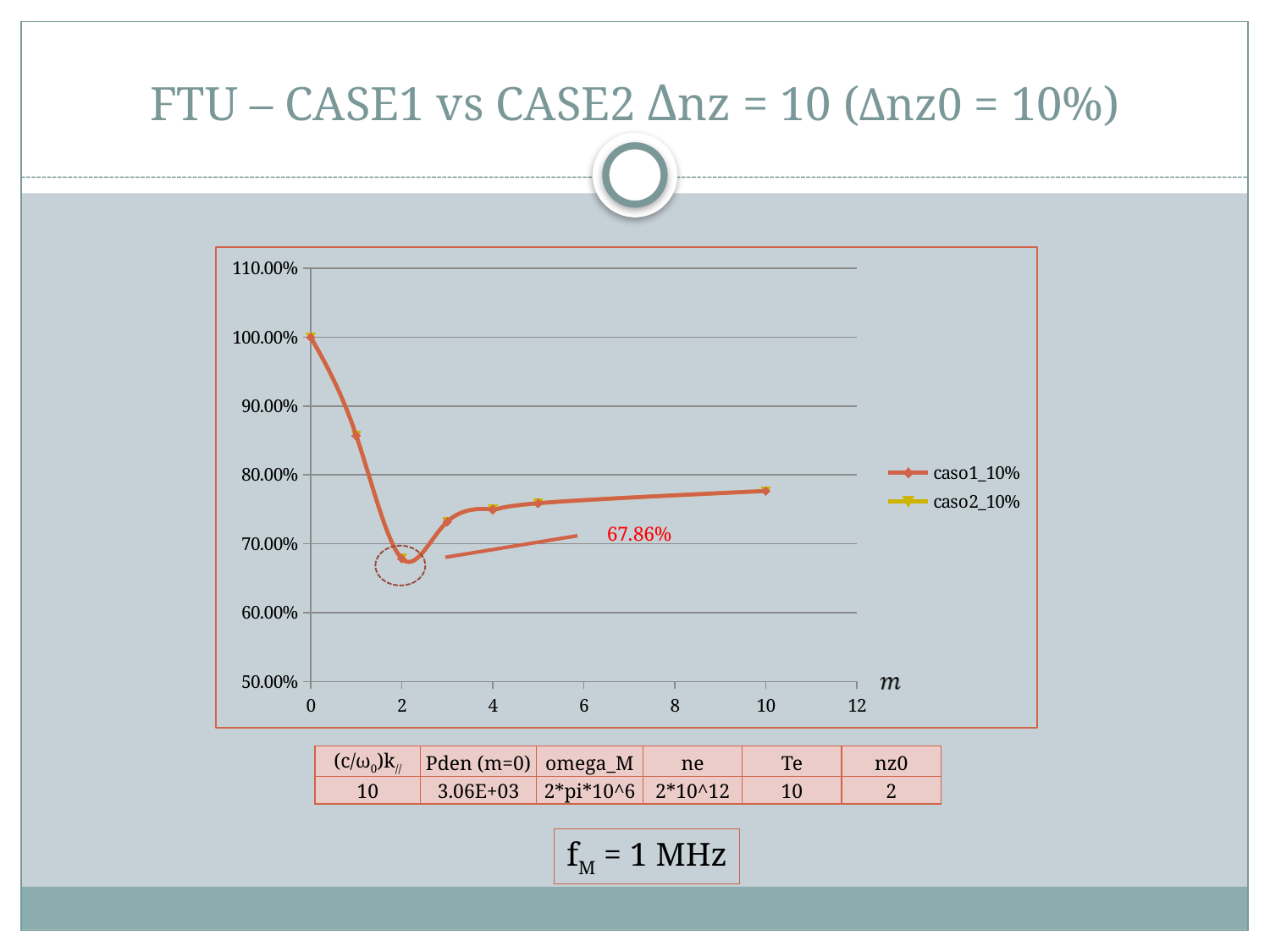
What label is shown on the x axis of the chart? m What value is annotated in red at the circled minimum of the curve? 67.86% What are the two series names shown in the chart legend? caso1_10% and caso2_10% What kind of chart is shown on the slide? line chart What is the value of the curve at m = 0? 100.00% At which value of m does the curve reach its highest point? 0 Is the value at m = 10 greater or less than 80.00%? less Do the values rise or fall as m increases from 2 to 10? rise Which is larger, the value at m = 1 or the value at m = 3? m = 1 How many series does the chart legend list? 2 Is the value at m = 1 greater or less than 80.00%? greater At which value of m does the curve reach its lowest point? 2